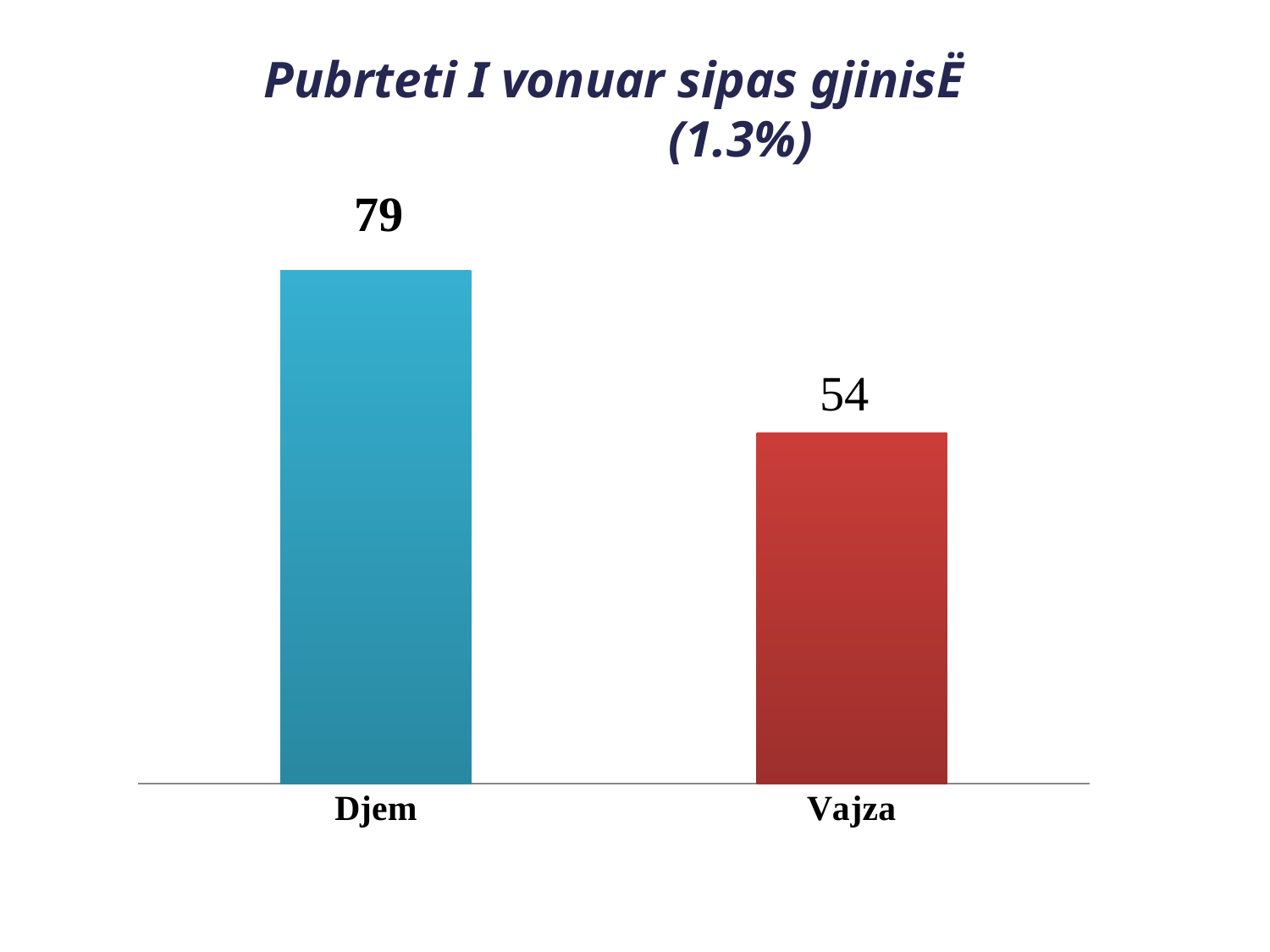
What is the value for Djem? 79 What is the title of the chart? Pubrteti I vonuar sipas gjinisË (1.3%) What is the total of the values for Djem and Vajza? 133 Which category has the lowest value? Vajza What is the value for Vajza? 54 How many categories are shown in the chart? 2 What is the difference between the values for Djem and Vajza? 25 What kind of chart is shown on the slide? Bar chart Which category has the highest value? Djem What colour is the bar for Vajza? Red Which is larger, the value for Djem or the value for Vajza? Djem